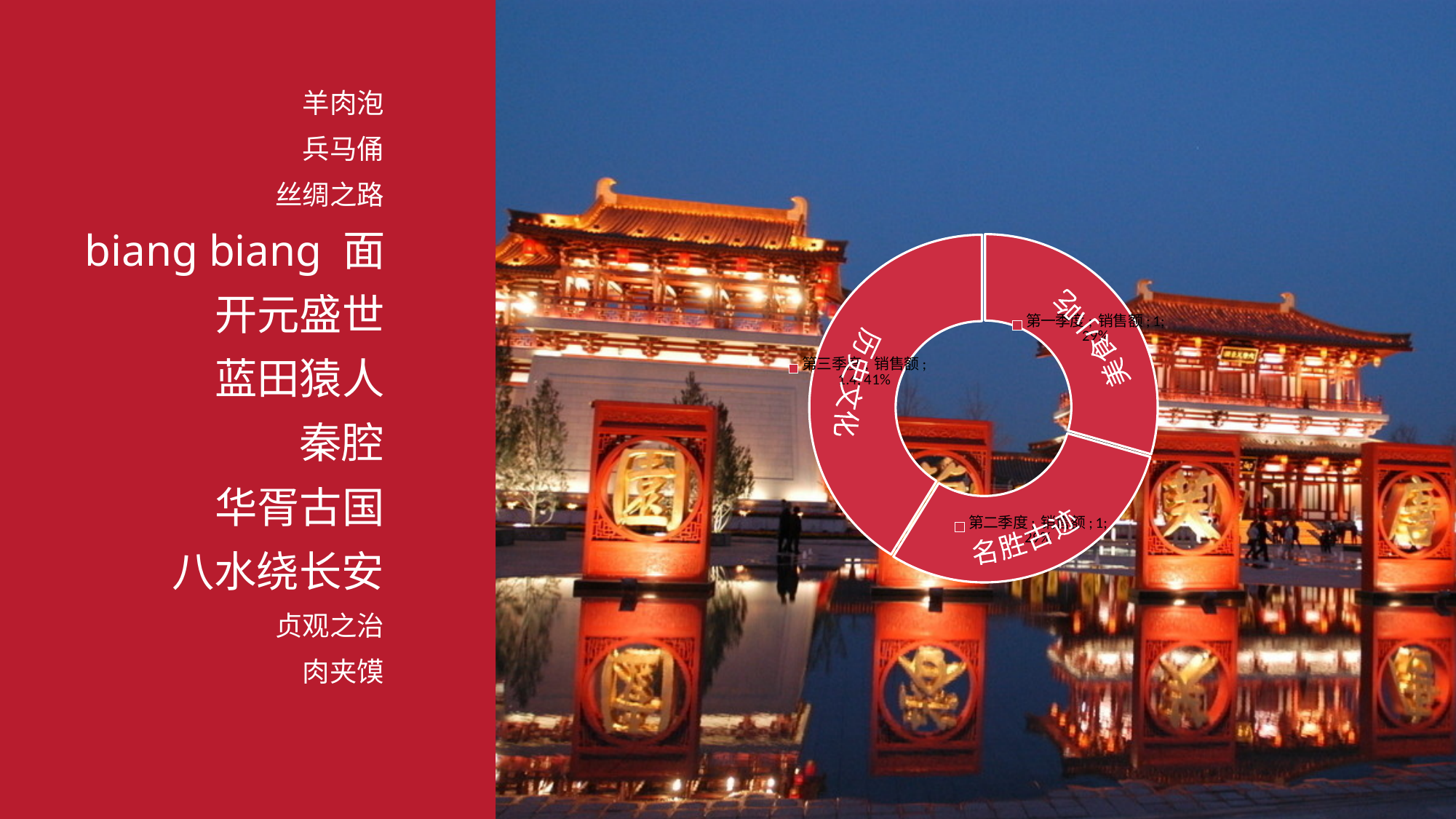
What is the value for 第一季度 in the chart? 1 What is the value for 第二季度 in the chart? 1 What text is overlaid on the 第三季度 slice of the doughnut chart? 历史文化 What share of the doughnut does 第三季度 represent? 41% Which quarter has the largest slice in the doughnut chart? 第三季度 Which is larger, the value for 第三季度 or the value for 第一季度? 第三季度 How many slices does the doughnut chart have? 3 What is the name of the data series shown in the chart's data labels? 销售额 What kind of chart is shown on the slide? Doughnut (pie) chart What is the value for 第三季度 in the chart? 1.4 What is the difference between the value for 第三季度 and the value for 第一季度? 0.4